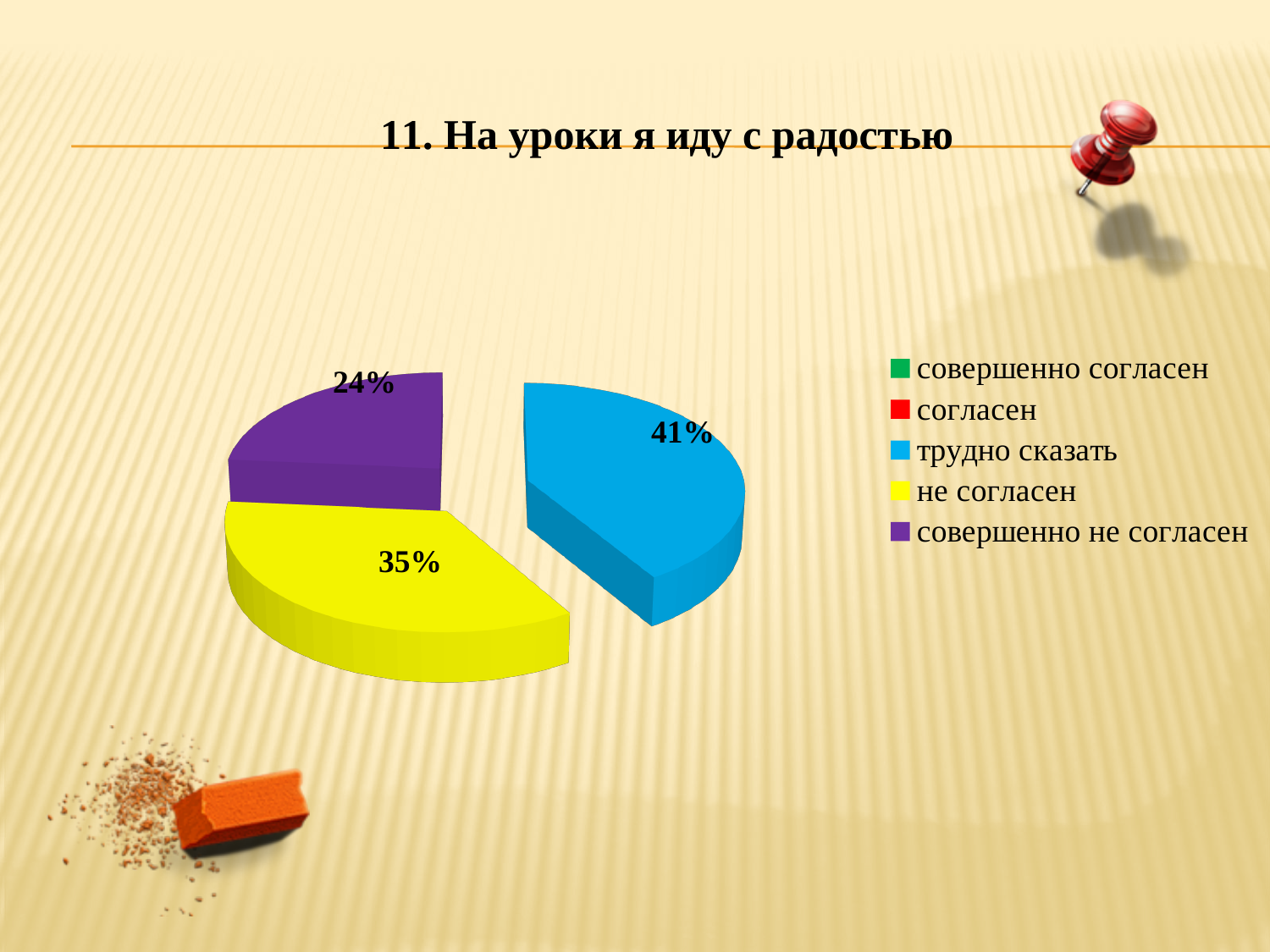
What kind of chart is shown on the slide? pie chart Which of the labelled slices is the smallest? совершенно не согласен What percentage of the pie is labelled for "не согласен"? 35% Which category has the largest slice of the pie? трудно сказать What is the difference in percentage points between the "трудно сказать" slice and the "не согласен" slice? 6 Which slice is larger: "не согласен" or "совершенно не согласен"? не согласен What is the difference in percentage points between the "не согласен" slice and the "совершенно не согласен" slice? 11 What percentage of the pie is labelled for "трудно сказать"? 41% What colour is the slice for "не согласен"? yellow What percentage of the pie is labelled for "совершенно не согласен"? 24% How many categories does the legend list? 5 What is the title of the chart on the slide? 11. На уроки я иду с радостью